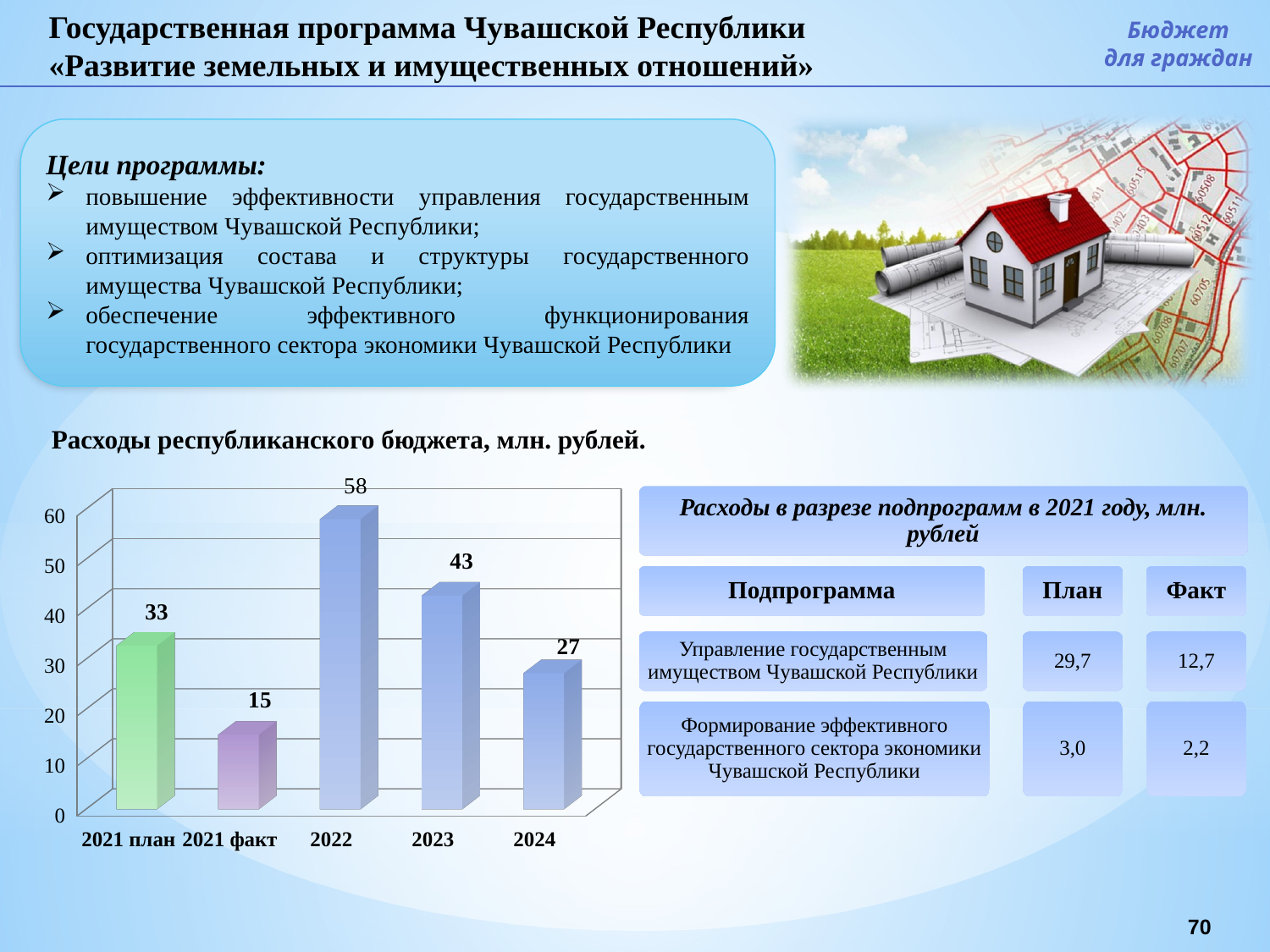
Is the value for 2021 план in the bar chart greater or less than 30? greater What is the value for 2022 in the bar chart? 58 Which category has the highest value in the bar chart? 2022 What is the difference between the values for 2021 план and 2021 факт in the bar chart? 18 How many categories are shown on the x axis of the bar chart? 5 Which category has the lowest value in the bar chart? 2021 факт Do the values in the bar chart rise or fall from 2022 to 2024? fall What is the difference between the values for 2022 and 2023 in the bar chart? 15 What kind of chart is shown on the slide? bar chart What is the value for 2021 факт in the bar chart? 15 Which is larger in the bar chart, the value for 2023 or the value for 2024? 2023 What is the value for 2024 in the bar chart? 27